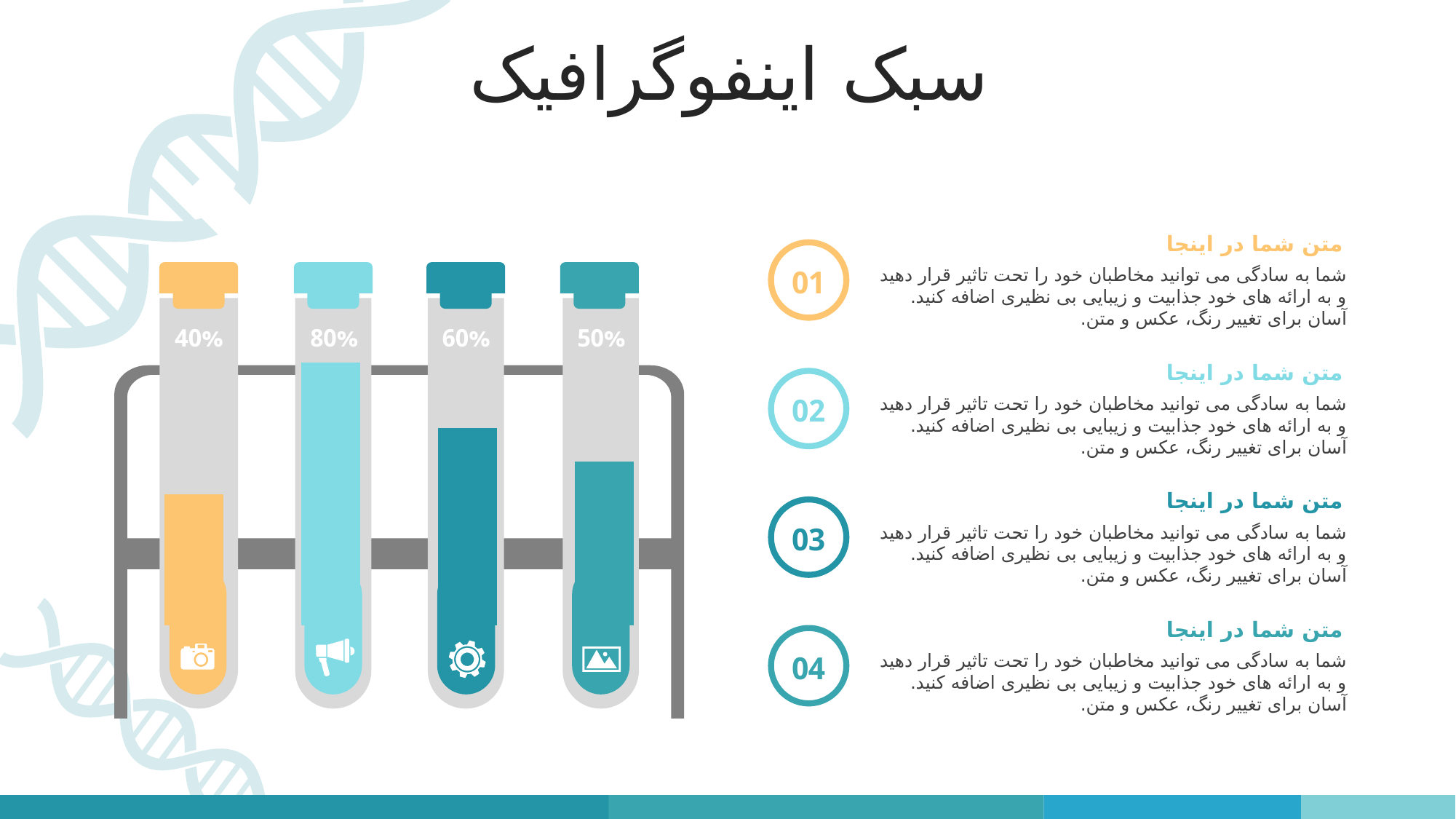
What percentage is shown on the leftmost (orange) test tube? 40% What percentage is shown on the second test tube from the left (light blue)? 80% Which test tube shows the lowest percentage? The leftmost (orange), 40% Which is larger, the percentage on the dark teal tube or the percentage on the rightmost teal tube? The dark teal tube (60%) What percentage is shown on the rightmost (teal) test tube? 50% What is the difference between the percentages on the dark teal tube and the teal (rightmost) tube? 10% Which test tube shows the highest percentage? The second from the left (light blue), 80% What is the difference between the percentages on the light blue tube and the orange tube? 40% Which icon appears at the bottom of the orange test tube? A camera What percentage is shown on the third test tube from the left (dark teal)? 60% What colour is the test tube showing 80%? Light blue How many test tubes are shown in the graphic? 4